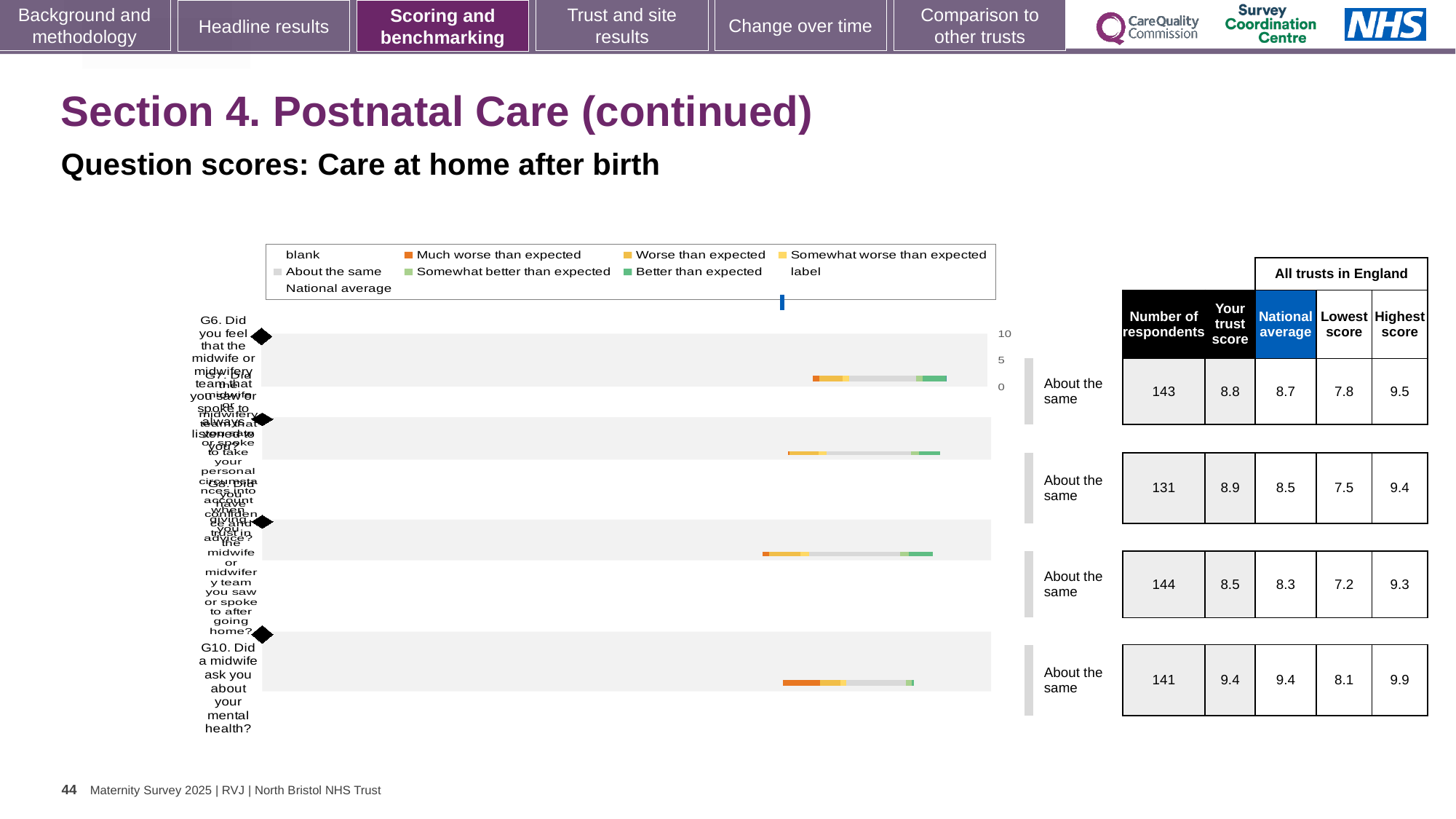
What kind of chart is shown on the slide? bar chart In the table beside the chart, what is the highest score for the third row (G8)? 9.3 How many question bars are plotted in the chart? 4 In the table beside the chart, what is the trust score for the second row (G7)? 8.9 In the table beside the chart, what is the lowest score for the first row (G6)? 7.8 In the table beside the chart, what is the number of respondents for the first row (G6)? 143 What is the maximum value shown on the chart's axis? 10 In the table beside the chart, what is the national average for the last row (G10, mental health question)? 9.4 In the table beside the chart, is the trust score for the third row (G8) higher or lower than its national average? higher Which row in the table beside the chart has the highest trust score? G10 (9.4) Which legend entry is shown in orange in the chart? Much worse than expected In the table beside the chart, what is the difference between the trust score and the national average for the second row (G7)? 0.4